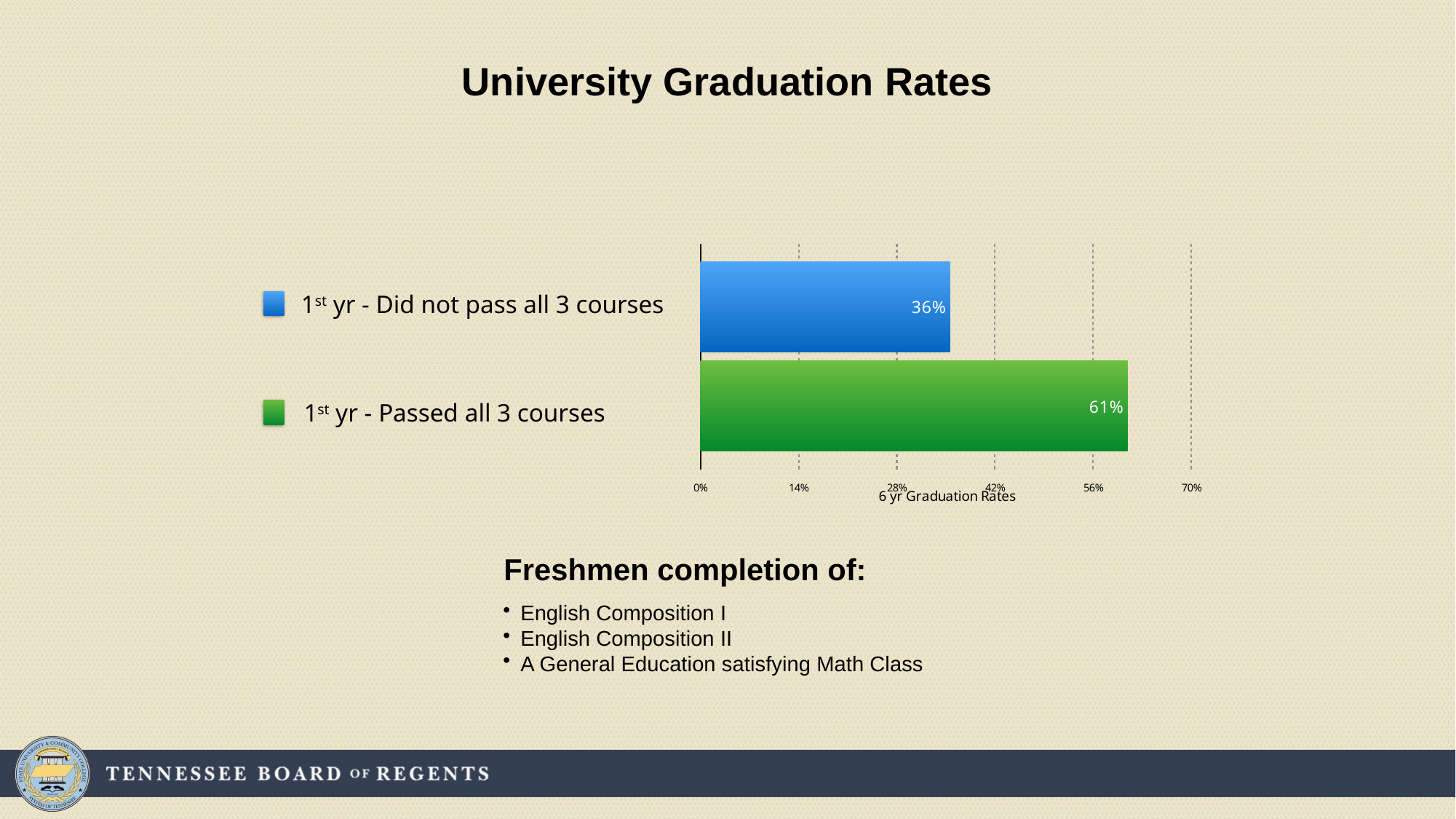
Is the graduation rate for students who passed all 3 courses greater or less than 56%? greater How many groups are plotted in the chart? 2 Which group has the higher 6 yr graduation rate? 1st yr - Passed all 3 courses What is the label on the horizontal axis of the chart? 6 yr Graduation Rates What colour is the bar for students who passed all 3 courses? Green Is the graduation rate higher for students who passed all 3 courses or for those who did not pass all 3 courses? Passed all 3 courses What is the 6 yr graduation rate for students who did not pass all 3 courses in their 1st year? 36% Is the graduation rate for students who did not pass all 3 courses greater or less than 42%? less What is the 6 yr graduation rate for students who passed all 3 courses in their 1st year? 61% What is the difference in 6 yr graduation rate between students who passed all 3 courses and those who did not? 25% What type of chart is shown on the slide? Bar chart Which group has the lower 6 yr graduation rate? 1st yr - Did not pass all 3 courses